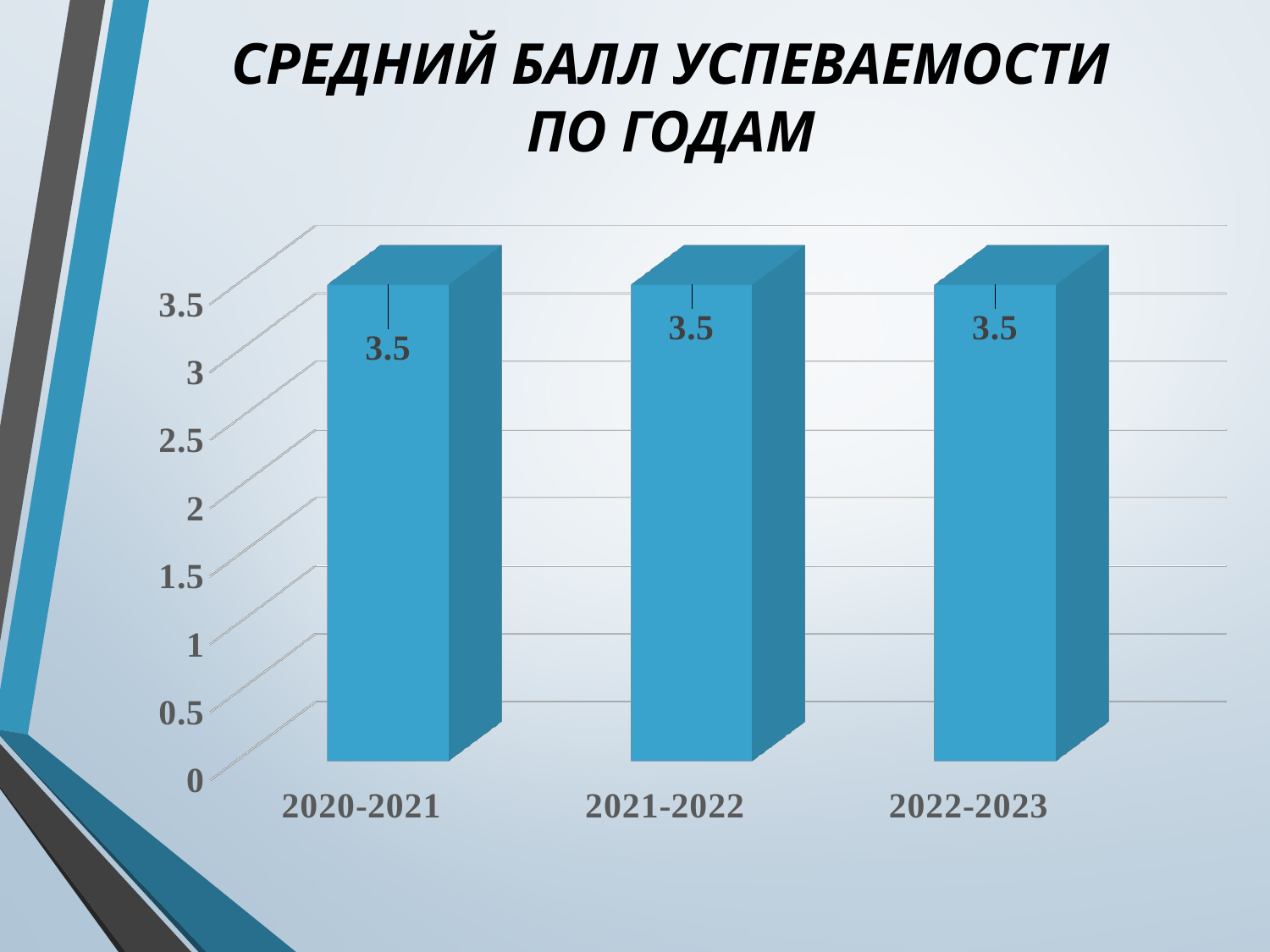
What is the value for 2021-2022? 3.5 What is the highest tick label shown on the vertical axis? 3.5 Do the values rise, fall, or stay the same from 2020-2021 to 2022-2023? Stay the same Is the value for 2021-2022 larger than, smaller than, or equal to the value for 2022-2023? Equal What is the title of the chart on the slide? СРЕДНИЙ БАЛЛ УСПЕВАЕМОСТИ ПО ГОДАМ What is the difference between the values for 2022-2023 and 2020-2021? 0 Is the value for 2022-2023 greater or less than 2? greater How many categories (academic years) are shown on the chart? 3 What kind of chart is shown on the slide? Bar chart Is the value for 2020-2021 greater or less than 3? greater What is the value for 2022-2023? 3.5 What is the value for 2020-2021? 3.5